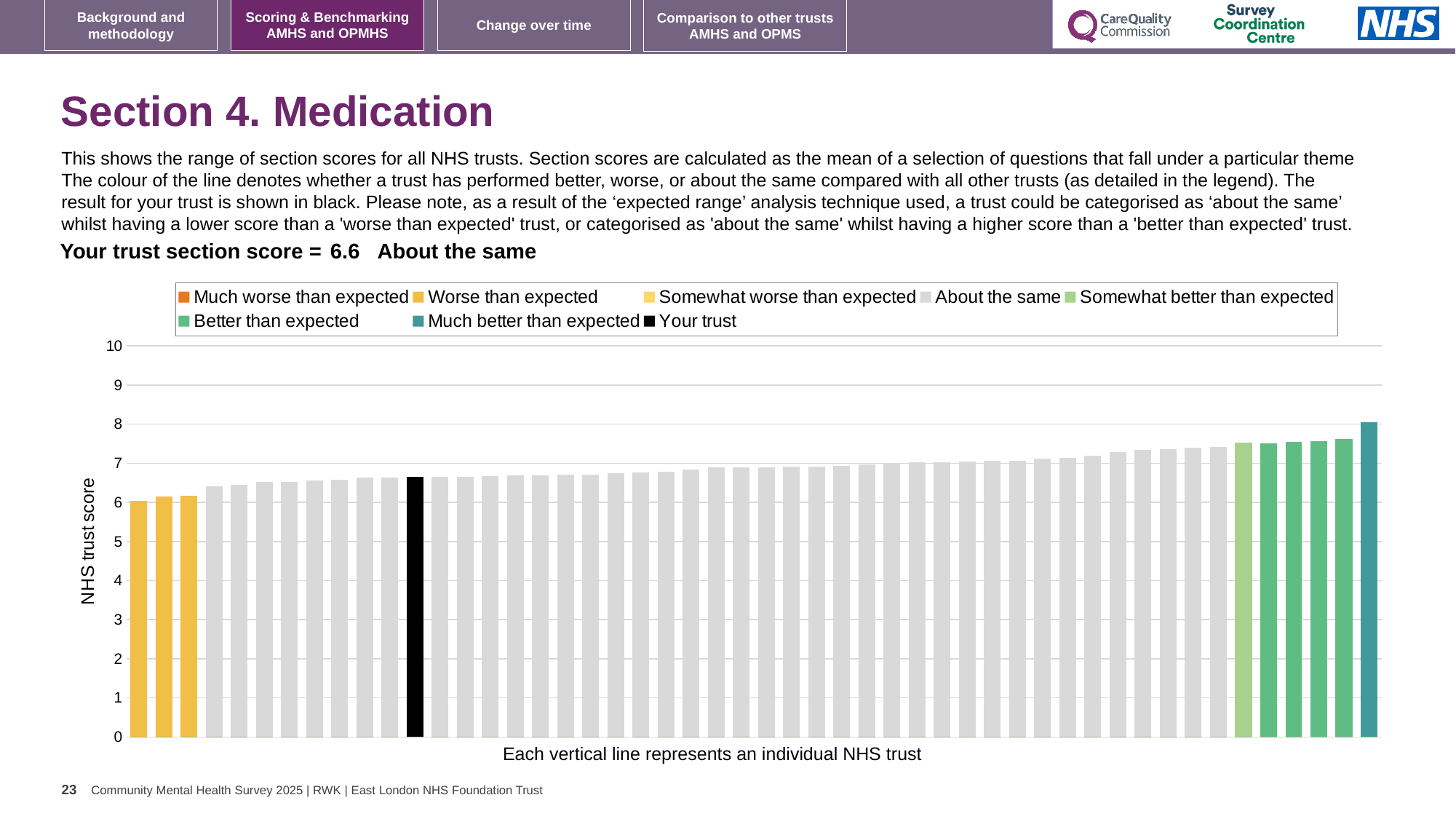
Is the value of the tallest bar in the chart greater or less than 7? greater Is the value of the black 'Your trust' bar greater or less than 5? greater Which legend category does the tallest bar in the chart belong to? Much better than expected What colour is the bar representing your trust? black Which category is your trust placed in for the Medication section score? About the same What kind of chart is shown on the slide? bar chart How many entries does the chart legend list? 8 What is the label on the vertical axis of the chart? NHS trust score Do the bar values rise or fall from left to right across the chart? rise Which is larger, the rightmost bar or the leftmost bar? the rightmost bar Is the value of the leftmost bar in the chart greater or less than 7? less What is the section score for your trust shown on the slide? 6.6